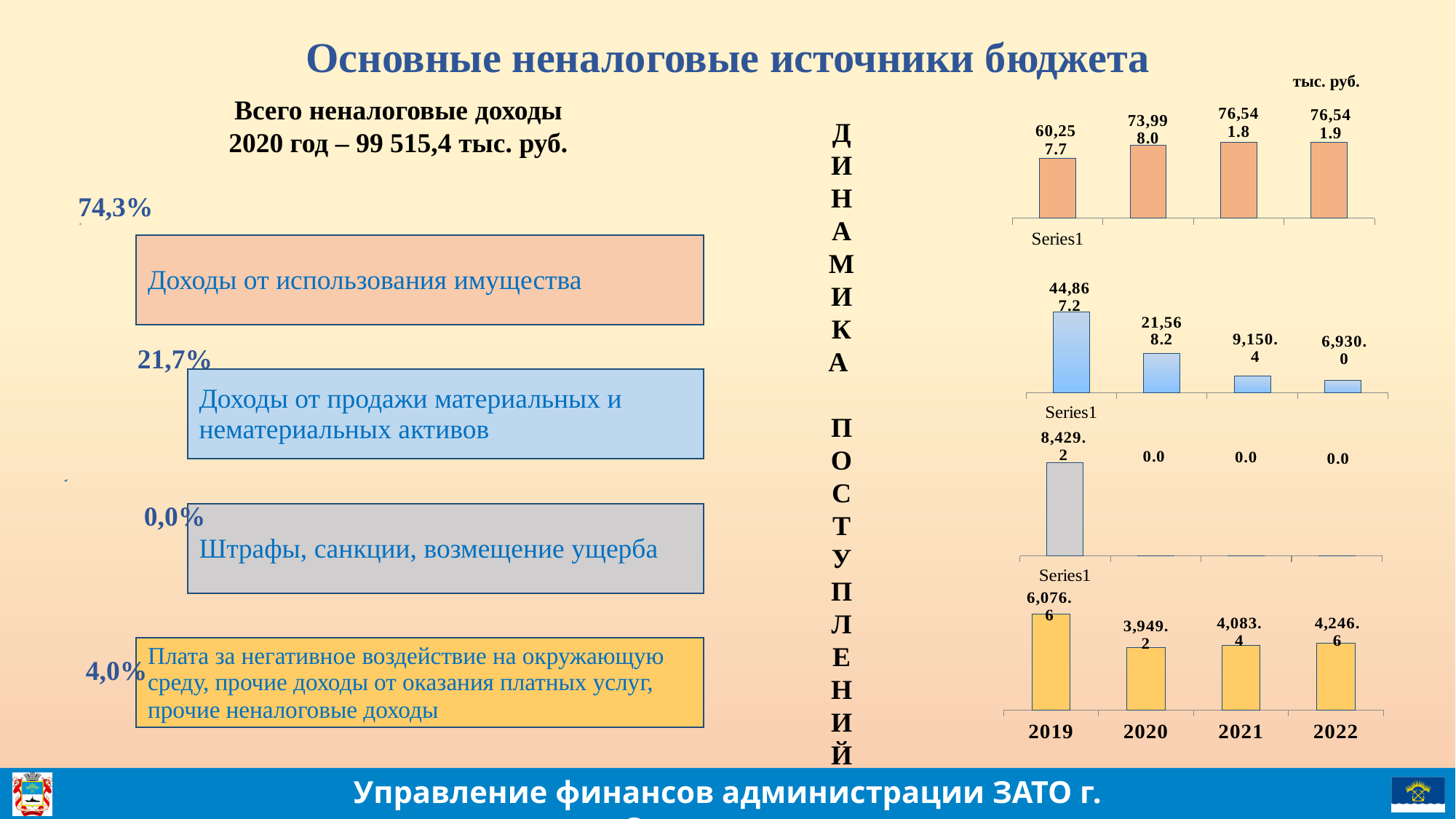
In the second (blue) chart on the right, do the values rise or fall from 2019 to 2022? fall How many bars does the bottom (yellow) chart on the right have? 4 In the bottom (yellow) chart on the right, what is the difference between the 2022 and 2021 values? 163.2 In the second (blue) chart on the right, which is larger, the value for 2020 or the value for 2021? 2020 What kind of chart is the top (orange) chart on the right? bar chart In the top (orange) chart on the right, which year has the lowest value? 2019 In the third (grey) chart on the right, what is the value for 2021? 0.0 In the top (orange) chart on the right, what is the value for 2020? 73,998.0 In the bottom (yellow) chart on the right, which year has the highest value? 2019 In the second (blue) chart on the right, what is the value for 2019? 44,867.2 In the top (orange) chart on the right, what is the difference between the 2020 and 2019 values? 13,740.3 In the third (grey) chart on the right, what is the value for 2019? 8,429.2